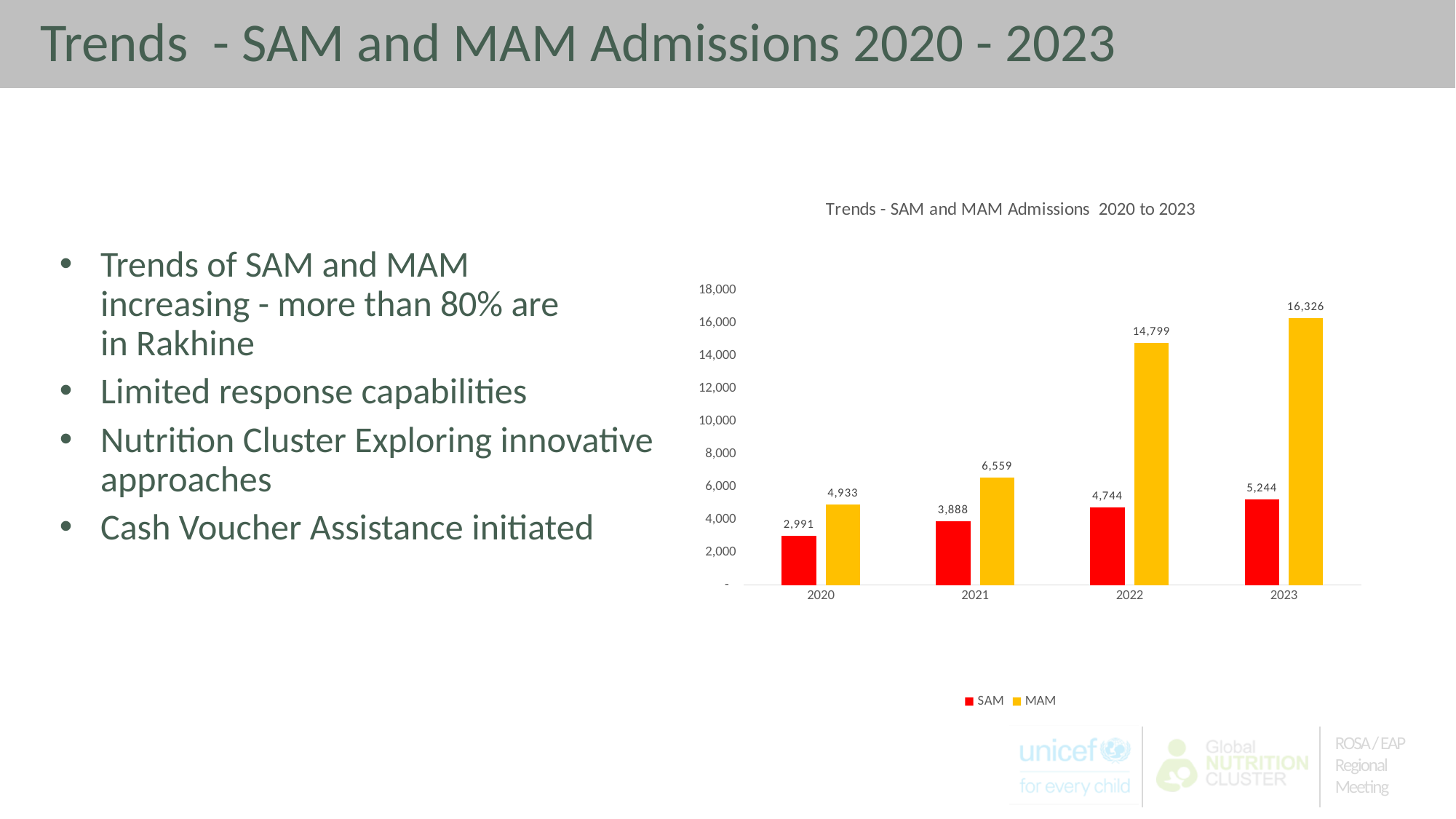
What is the MAM admissions value for 2023? 16,326 Which year has the lowest SAM admissions? 2020 Is the MAM admissions value for 2022 greater or less than 12,000? greater How many series does the legend list? 2 Which year has the highest MAM admissions? 2023 Do MAM admissions rise or fall from 2020 to 2023? Rise What is the SAM admissions value for 2022? 4,744 What is the SAM admissions value for 2020? 2,991 Which is larger in 2021, SAM admissions or MAM admissions? MAM How many years are shown on the x axis? 4 What is the difference between MAM and SAM admissions in 2022? 10,055 What kind of chart is shown on the slide? Bar chart